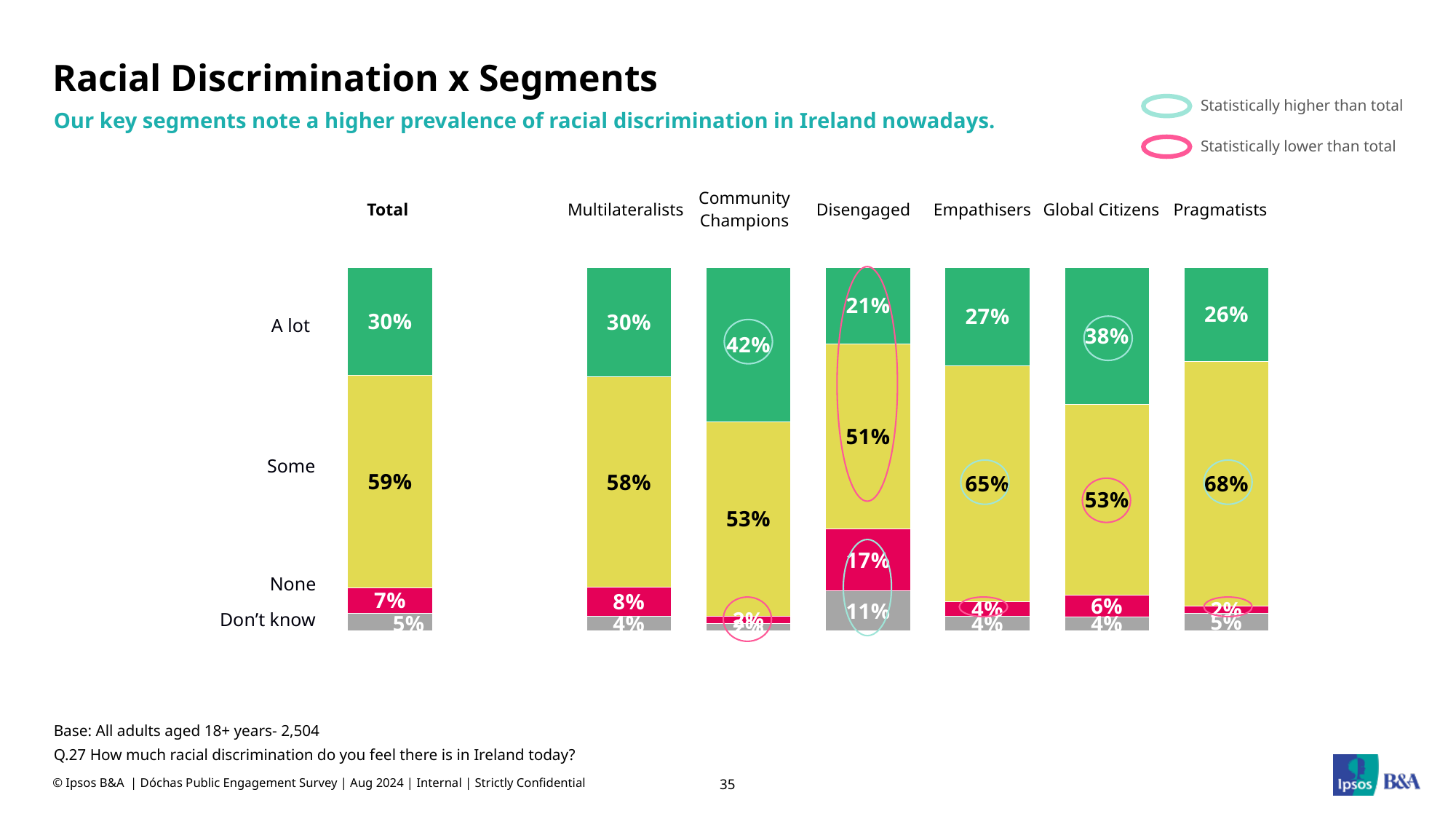
What is the 'Some' value for Pragmatists? 68% What is the difference between the 'A lot' value for Community Champions and the Total 'A lot' value? 12 percentage points Which segment has the lowest 'A lot' value? Disengaged What type of chart is shown on the slide? Stacked bar chart What percentage of the Total say there is 'A lot' of racial discrimination in Ireland today? 30% How many segment bars are shown in addition to the Total bar? 6 Which segment has the highest 'A lot' value? Community Champions What is the 'Don't know' value for the Disengaged segment? 11% What is the 'None' value for the Disengaged segment? 17% What does a pink circle around a value indicate, according to the key? Statistically lower than total Which is larger: the 'Some' value for Empathisers or the 'Some' value for Global Citizens? Empathisers What is the 'A lot' value for Global Citizens? 38%